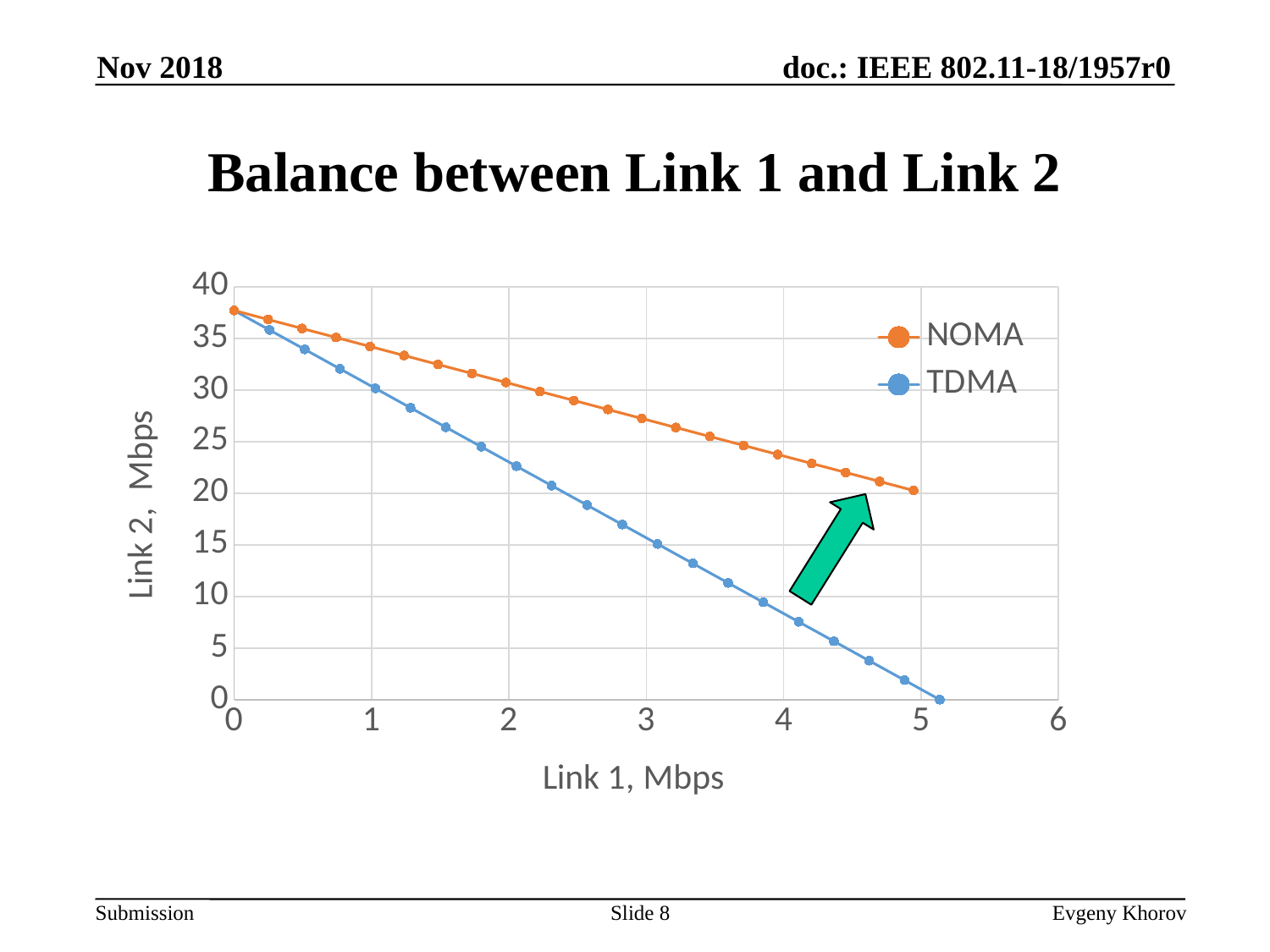
Do the Link 2 values for the NOMA series rise or fall as Link 1 increases? fall What kind of chart is shown on the slide? line chart Is the Link 2 value for NOMA at Link 1 = 4 Mbps greater or less than 20? greater Which two series are listed in the legend? NOMA and TDMA What is the title of the chart? Balance between Link 1 and Link 2 Is the Link 2 value for NOMA at Link 1 = 1 Mbps greater or less than 35? less Which series falls more steeply as Link 1 increases, NOMA or TDMA? TDMA At Link 1 = 4 Mbps, which series has the higher Link 2 value, NOMA or TDMA? NOMA Is the Link 2 value for TDMA at Link 1 = 5 Mbps greater or less than 5? less How many series does the legend list? 2 Do the Link 2 values for the TDMA series rise or fall as Link 1 increases? fall